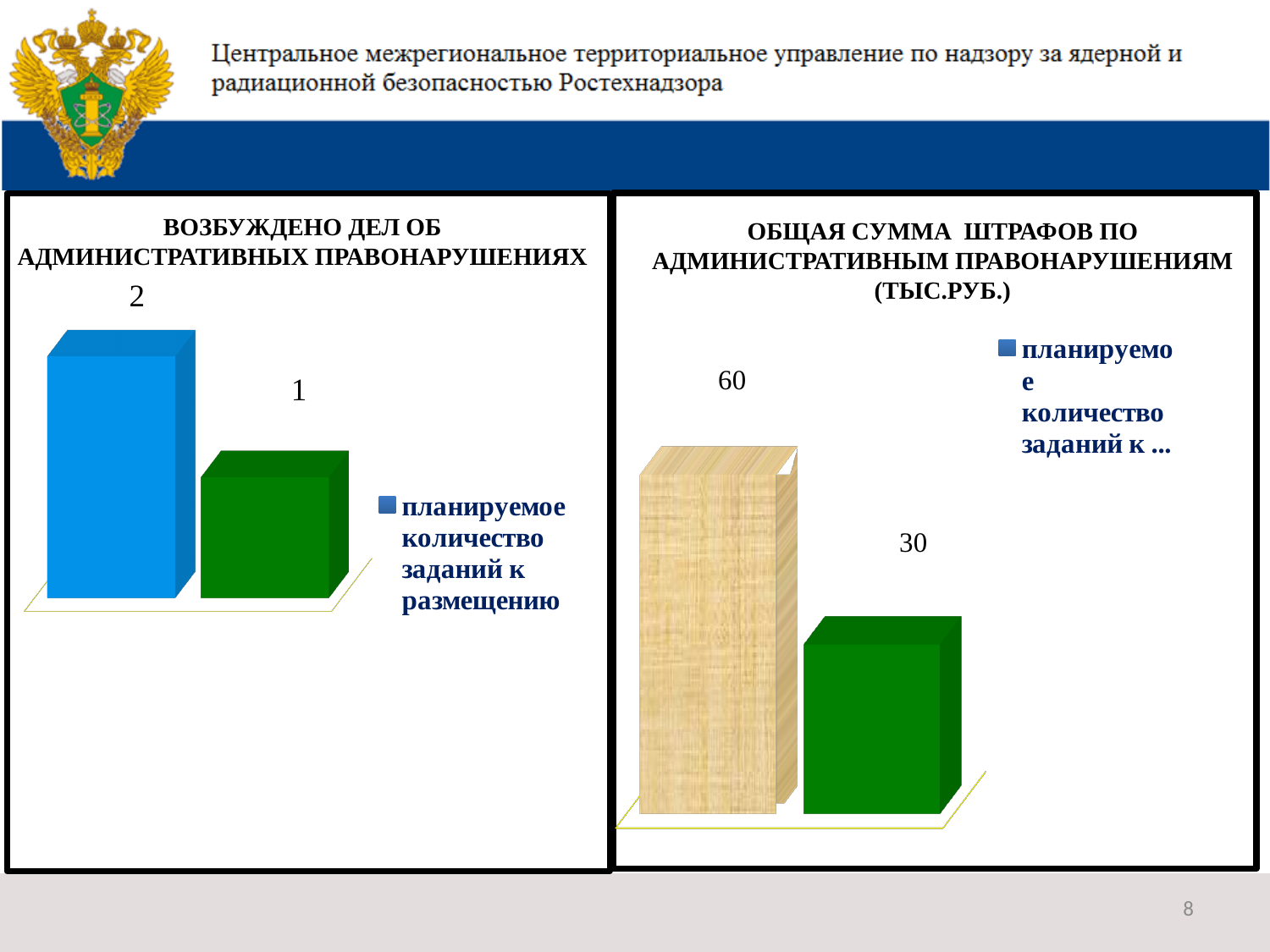
On the right chart, how many entries does the legend list? 1 On the left chart, how many bars are plotted? 2 On the right chart, what is the difference between the two bar values? 30 On the left chart, what kind of chart is shown? bar chart On the left chart titled "ВОЗБУЖДЕНО ДЕЛ ОБ АДМИНИСТРАТИВНЫХ ПРАВОНАРУШЕНИЯХ", what value is labelled on the green (right) bar? 1 On the left chart titled "ВОЗБУЖДЕНО ДЕЛ ОБ АДМИНИСТРАТИВНЫХ ПРАВОНАРУШЕНИЯХ", what value is labelled on the blue (left) bar? 2 On the left chart, what is the difference between the two bar values? 1 What unit is given in parentheses in the title of the right chart? ТЫС.РУБ. On the right chart titled "ОБЩАЯ СУММА ШТРАФОВ ПО АДМИНИСТРАТИВНЫМ ПРАВОНАРУШЕНИЯМ (ТЫС.РУБ.)", what value is labelled on the green (right) bar? 30 On the right chart titled "ОБЩАЯ СУММА ШТРАФОВ ПО АДМИНИСТРАТИВНЫМ ПРАВОНАРУШЕНИЯМ (ТЫС.РУБ.)", what value is labelled on the left (wood-textured) bar? 60 On the right chart, do the values rise or fall from left to right? fall On the right chart, which bar is taller, the left wood-textured bar or the right green bar? the left wood-textured bar